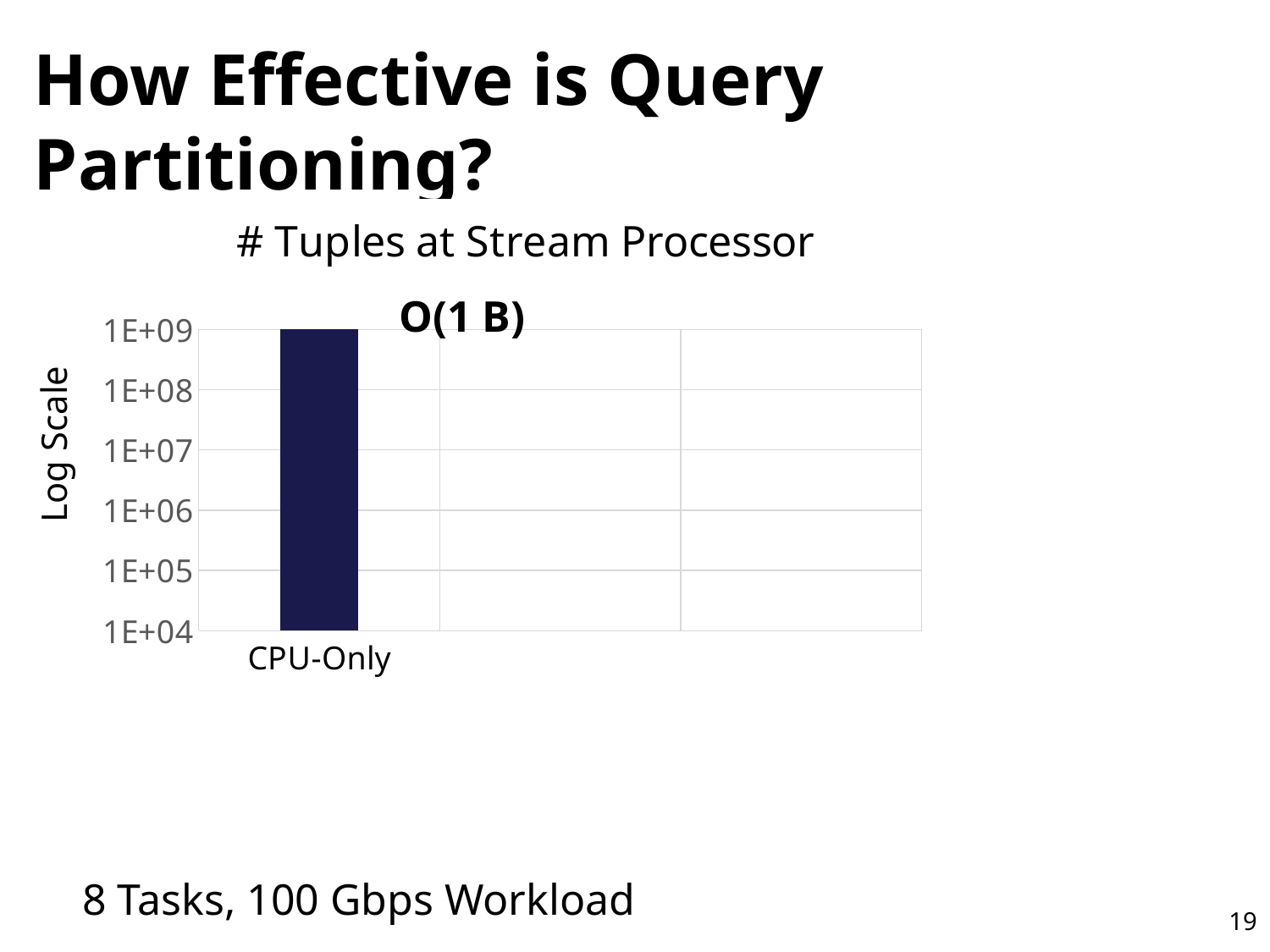
How many labeled categories are plotted in the chart? 1 Is the value for CPU-Only greater or less than 1E+06? greater What is the highest tick shown on the vertical axis? 1E+09 What is the title of the chart? # Tuples at Stream Processor Which axis tick does the CPU-Only bar reach? 1E+09 Is the value for CPU-Only greater or less than 1E+08? greater What kind of chart is shown on the slide? bar chart What is the label on the vertical axis of the chart? Log Scale What is the lowest tick shown on the vertical axis? 1E+04 What annotation is printed above the CPU-Only bar? O(1 B) Which category is plotted in the chart? CPU-Only